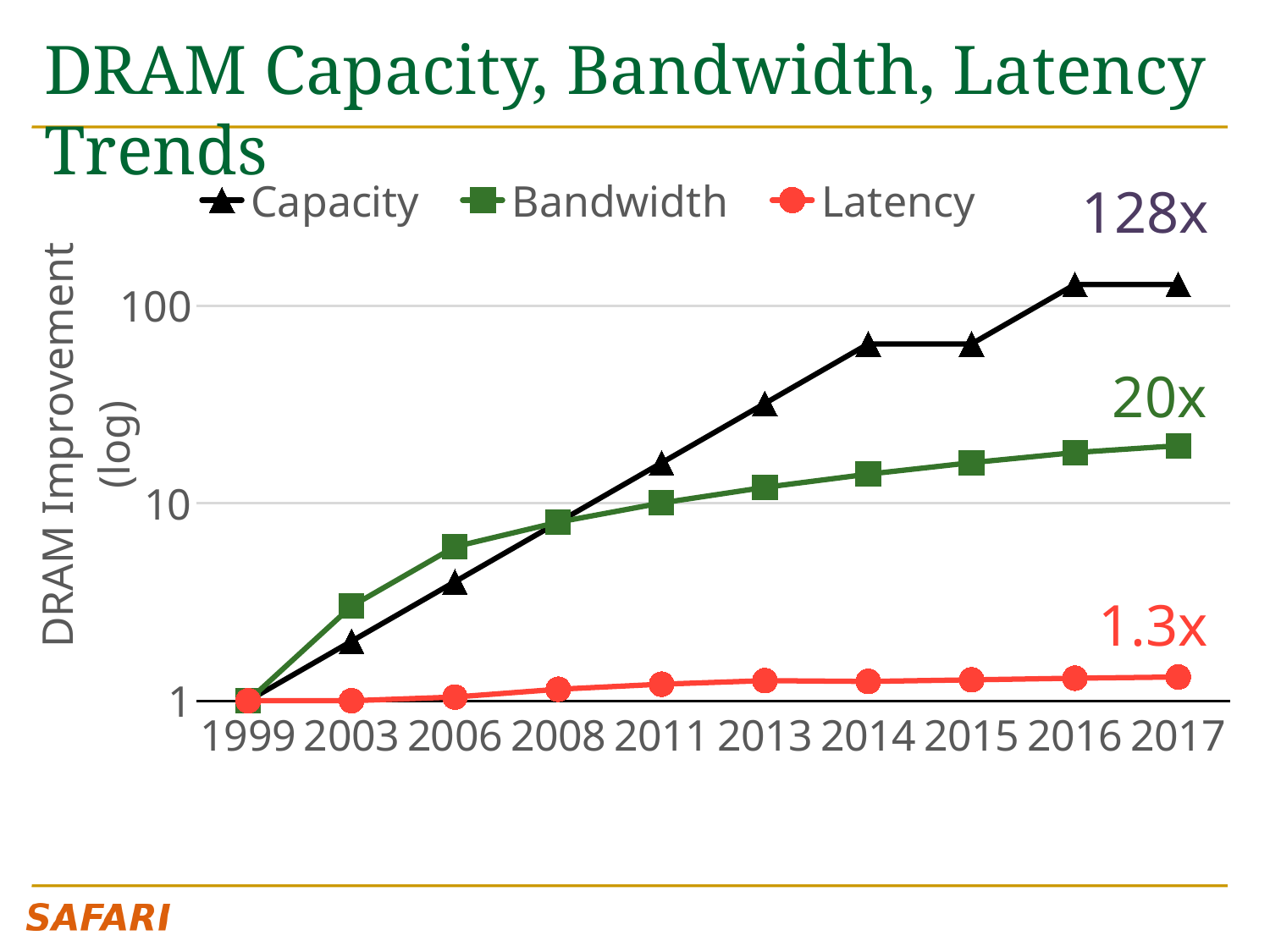
In 2006, which is larger, the Bandwidth value or the Capacity value? Bandwidth What is the label on the y axis? DRAM Improvement (log) What improvement factor is labelled for Bandwidth in 2017? 20x Does the Capacity series rise or fall from 1999 to 2017? rise Is the Capacity value for 2016 greater or less than 100? greater Which series has the lowest value in 2017? Latency What improvement factor is labelled for Capacity in 2017? 128x How many series does the legend list? 3 How many years are labelled along the x axis? 10 What improvement factor is labelled for Latency in 2017? 1.3x What kind of chart is shown on the slide? line chart Which series has the highest value in 2017? Capacity